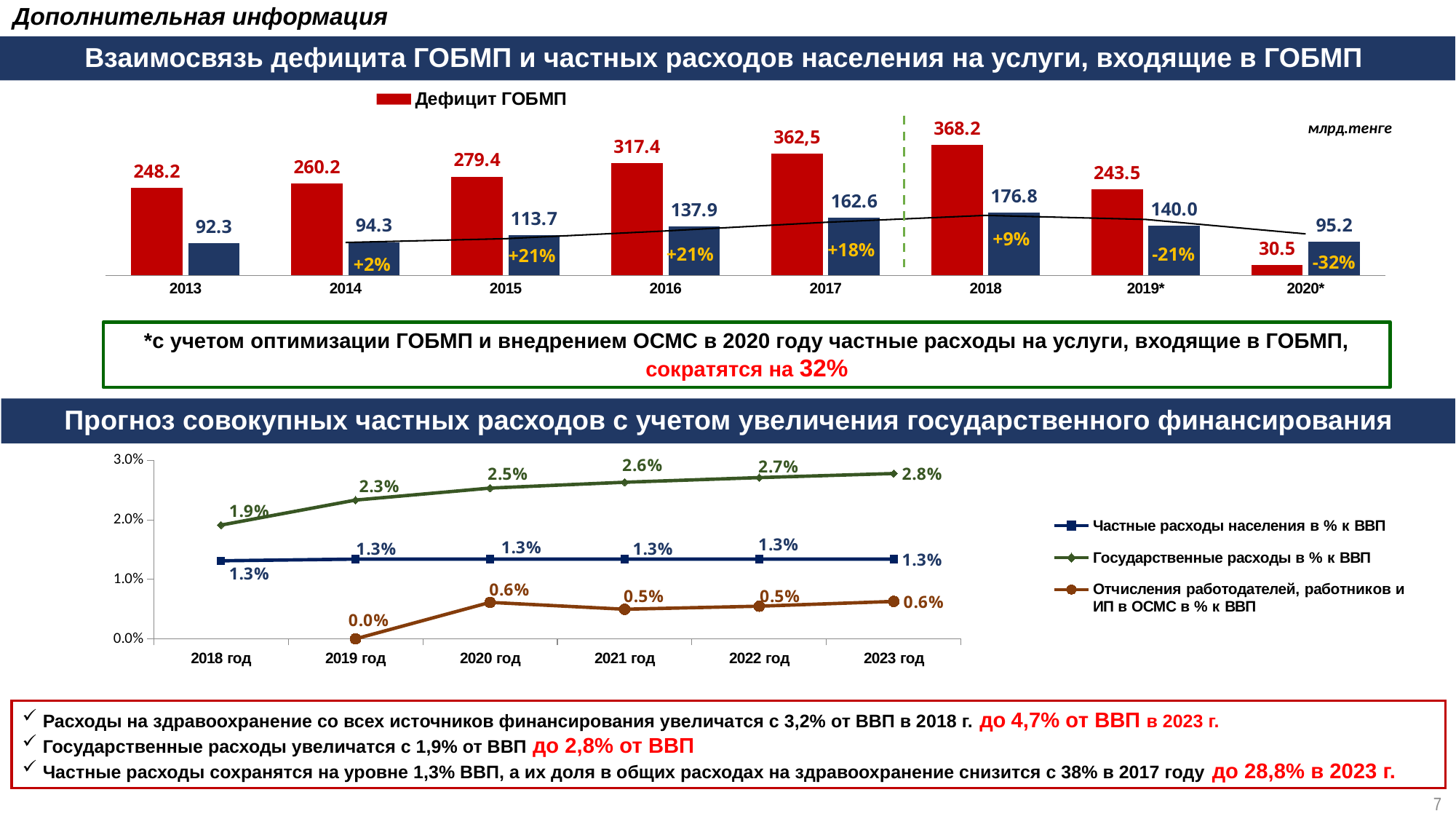
In the top chart, what is the value of Дефицит ГОБМП for 2016? 317.4 In the top chart, what is the difference between the Дефицит ГОБМП values for 2018 and 2017? 5.7 In the top chart, what is the value of the blue bar for 2018? 176.8 In the top chart, which year has the lowest Дефицит ГОБМП? 2020* What kind of chart is the top chart? bar chart In the bottom chart, what is the value of Государственные расходы в % к ВВП for 2021 год? 2.6% In the top chart, how many years are shown on the x axis? 8 How many series does the legend of the bottom chart list? 3 In the bottom chart, which is larger in 2023 год: Государственные расходы в % к ВВП or Частные расходы населения в % к ВВП? Государственные расходы в % к ВВП In the bottom chart, do the values of Государственные расходы в % к ВВП rise or fall from 2018 год to 2023 год? rise In the top chart, which year has the highest Дефицит ГОБМП? 2018 In the top chart, what percentage change is shown on the blue bar for 2020*? -32%